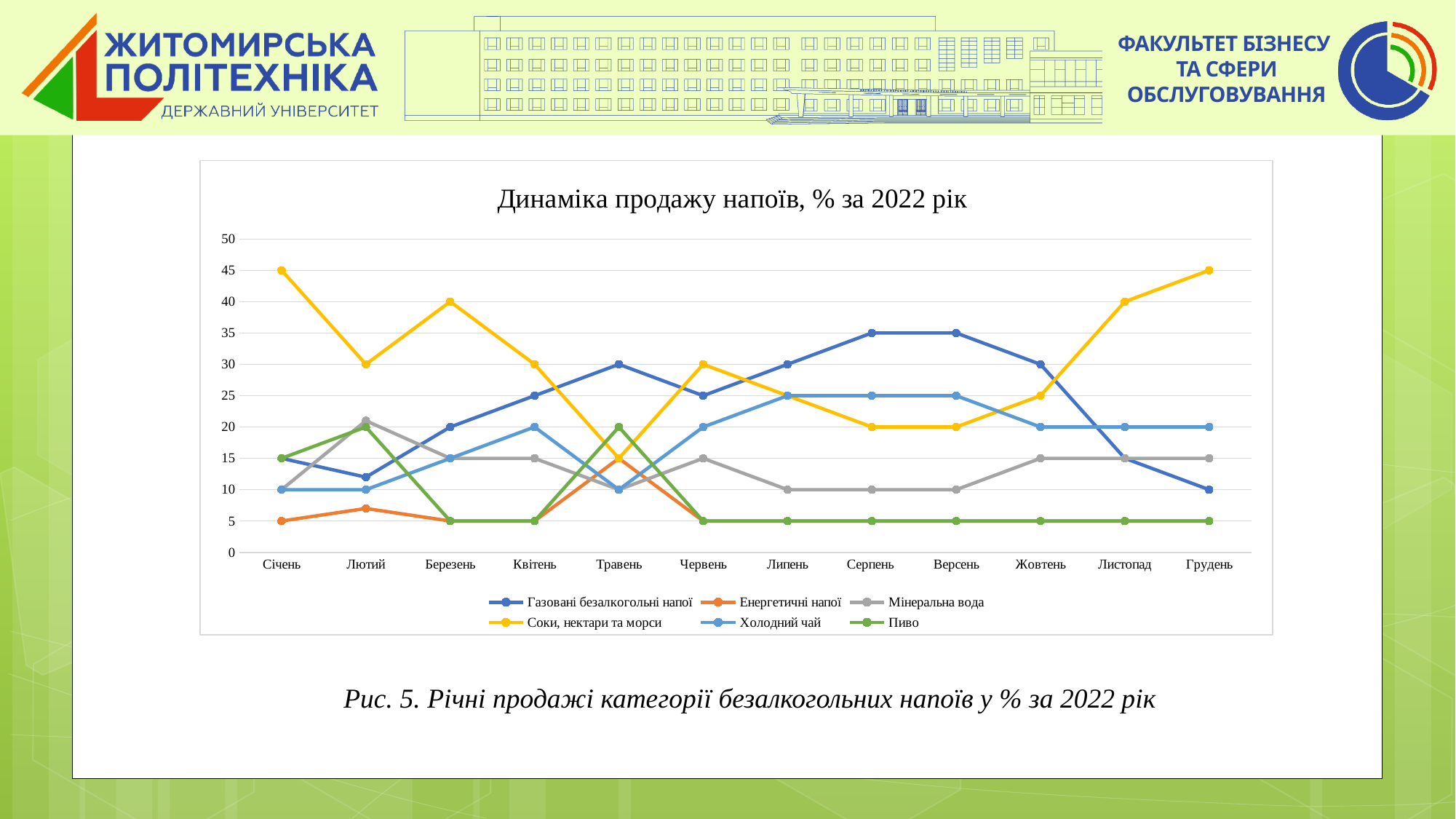
How many months are shown along the x axis? 12 Which series has the highest value in Січень? Соки, нектари та морси How many series does the legend list? 6 What is the difference between the value for Соки, нектари та морси in Січень and in Лютий? 15 What is the value for Газовані безалкогольні напої in Серпень? 35 Is the value for Газовані безалкогольні напої in Лютий greater or less than 15? less Which series has the highest value in Серпень? Газовані безалкогольні напої Does the value for Соки, нектари та морси rise or fall from Версень to Грудень? Rise What is the value for Соки, нектари та морси in Січень? 45 What type of chart is shown on the slide? Line chart Which is larger in Травень: Газовані безалкогольні напої or Соки, нектари та морси? Газовані безалкогольні напої What is the value for Холодний чай in Липень? 25